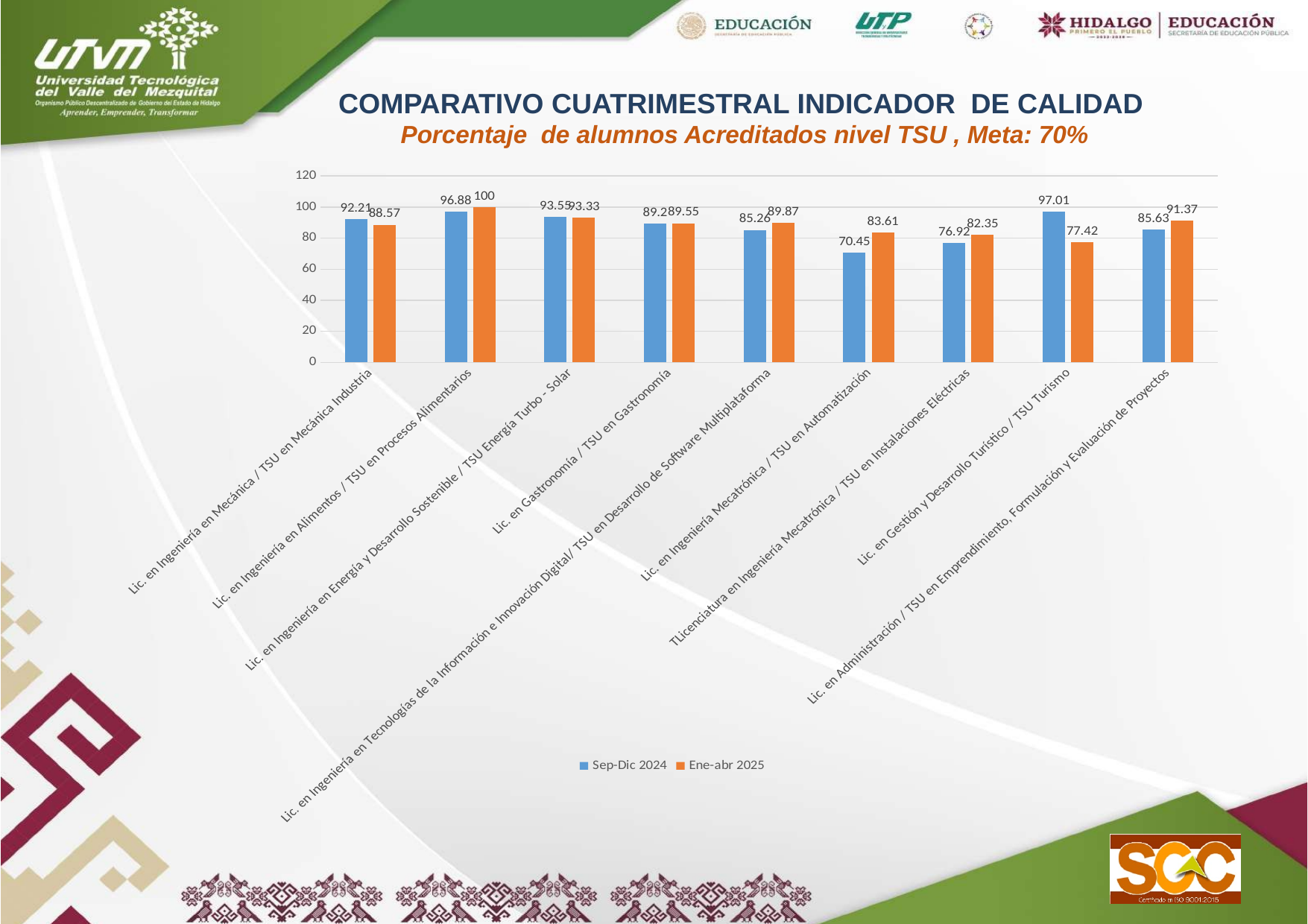
What is the Ene-abr 2025 value for Lic. en Gestión y Desarrollo Turístico / TSU Turismo? 77.42 Which category has the lowest Sep-Dic 2024 value? Lic. en Ingeniería Mecatrónica / TSU en Automatización How many series does the legend list? 2 What is the difference between the Ene-abr 2025 and Sep-Dic 2024 values for Lic. en Ingeniería Mecatrónica / TSU en Automatización? 13.16 What is the Ene-abr 2025 value for Lic. en Administración / TSU en Emprendimiento, Formulación y Evaluación de Proyectos? 91.37 What kind of chart is shown on the slide? Bar chart How many categories are shown on the x axis of the chart? 9 What is the Sep-Dic 2024 value for Lic. en Ingeniería Mecatrónica / TSU en Automatización? 70.45 Which category has the lowest Ene-abr 2025 value? Lic. en Gestión y Desarrollo Turístico / TSU Turismo What is the difference between the Sep-Dic 2024 and Ene-abr 2025 values for Lic. en Gestión y Desarrollo Turístico / TSU Turismo? 19.59 For Lic. en Gestión y Desarrollo Turístico / TSU Turismo, which series has the larger value, Sep-Dic 2024 or Ene-abr 2025? Sep-Dic 2024 Which category has the highest Ene-abr 2025 value? Lic. en Ingeniería en Alimentos / TSU en Procesos Alimentarios